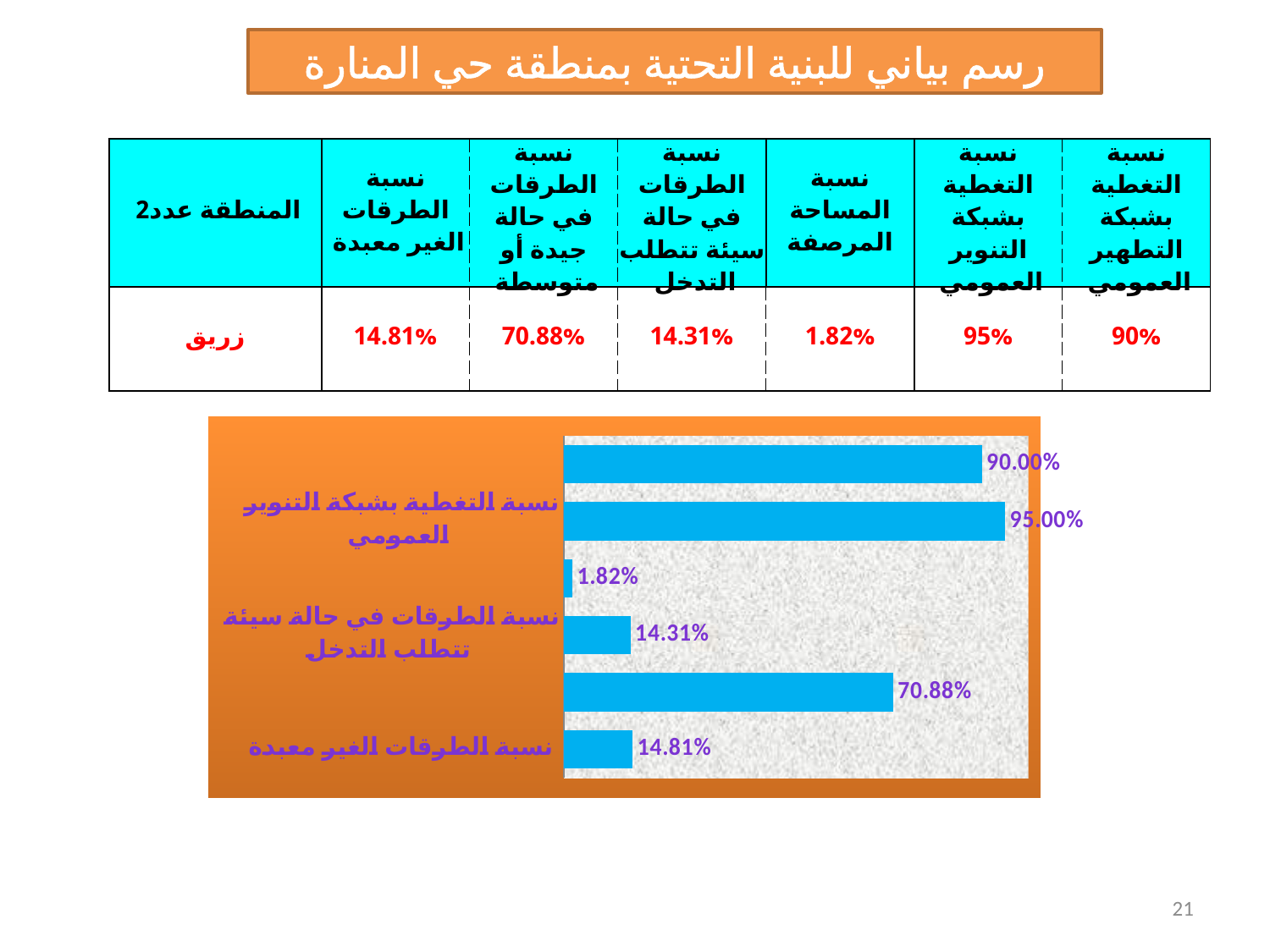
What is the value shown for نسبة التغطية بشبكة التنوير العمومي in the bar chart? 95.00% Which is larger: the value for نسبة التغطية بشبكة التنوير العمومي or the value for نسبة الطرقات في حالة سيئة تتطلب التدخل? نسبة التغطية بشبكة التنوير العمومي What is the value shown for نسبة الطرقات الغير معبدة in the bar chart? 14.81% What colour are the bars in the chart? Blue What is the difference between the value for نسبة الطرقات الغير معبدة and the value for نسبة الطرقات في حالة سيئة تتطلب التدخل? 0.50% What kind of chart is shown on the slide? Bar chart What is the highest value labelled on any bar in the chart? 95.00% What is the lowest value labelled on any bar in the chart? 1.82% What is the difference between the value for نسبة التغطية بشبكة التنوير العمومي and the value for نسبة الطرقات الغير معبدة? 80.19% What is the title shown at the top of the slide above the chart? رسم بياني للبنية التحتية بمنطقة حي المنارة How many bars are plotted in the chart? 6 What is the value shown for نسبة الطرقات في حالة سيئة تتطلب التدخل in the bar chart? 14.31%